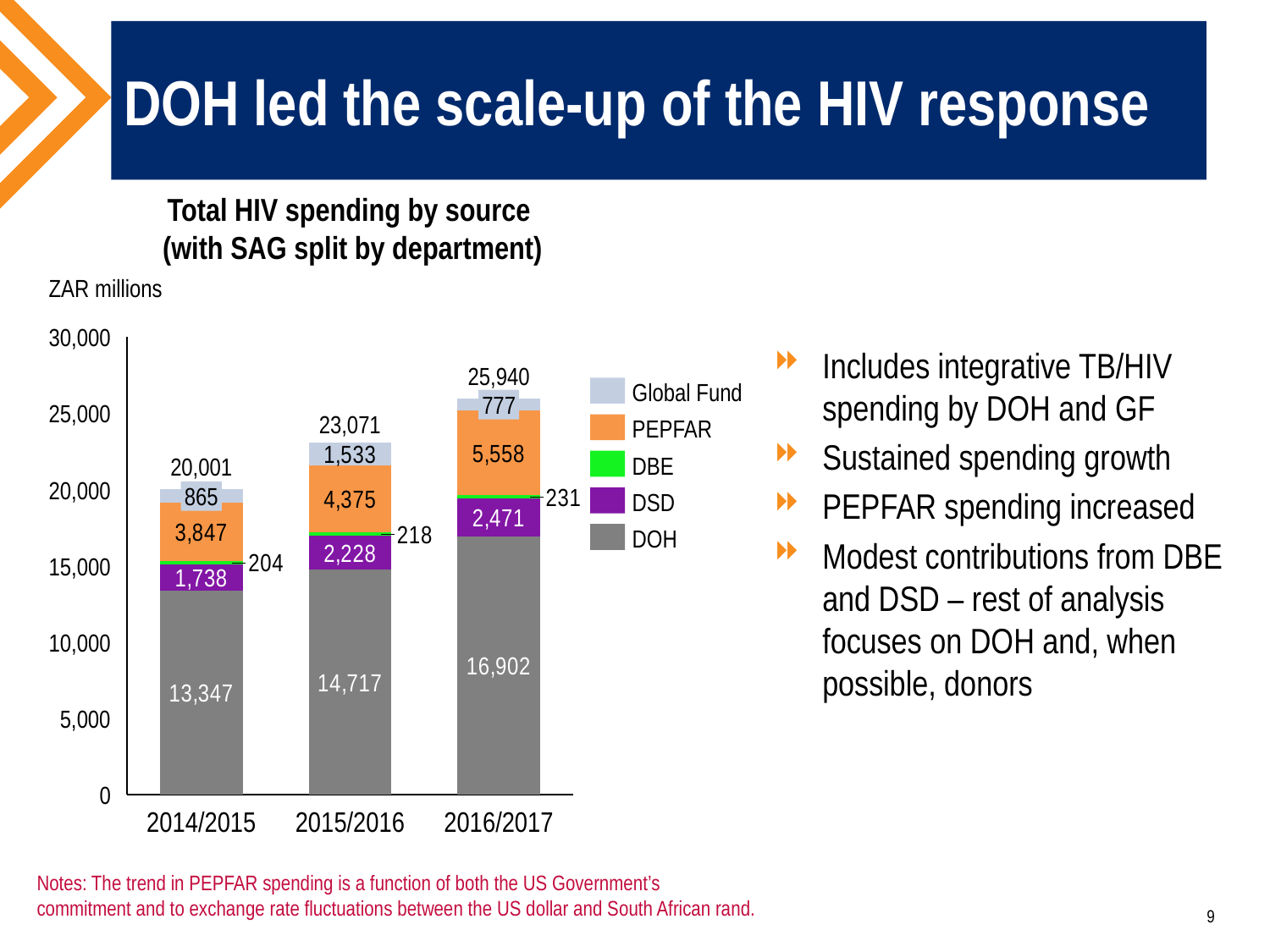
What was DOH spending in 2016/2017? 16,902 Which was larger in 2014/2015: DSD spending or Global Fund spending? DSD What kind of chart is shown? Stacked bar chart What was the total HIV spending in 2015/2016? 23,071 By how much did PEPFAR spending increase from 2015/2016 to 2016/2017? 1,183 Which year had the highest total HIV spending? 2016/2017 Which year had the lowest DSD spending? 2014/2015 What was DBE spending in 2016/2017? 231 What was PEPFAR spending in 2014/2015? 3,847 Does total HIV spending rise or fall from 2014/2015 to 2016/2017? Rise How many series does the legend list? 5 What was the Global Fund contribution in 2015/2016? 1,533